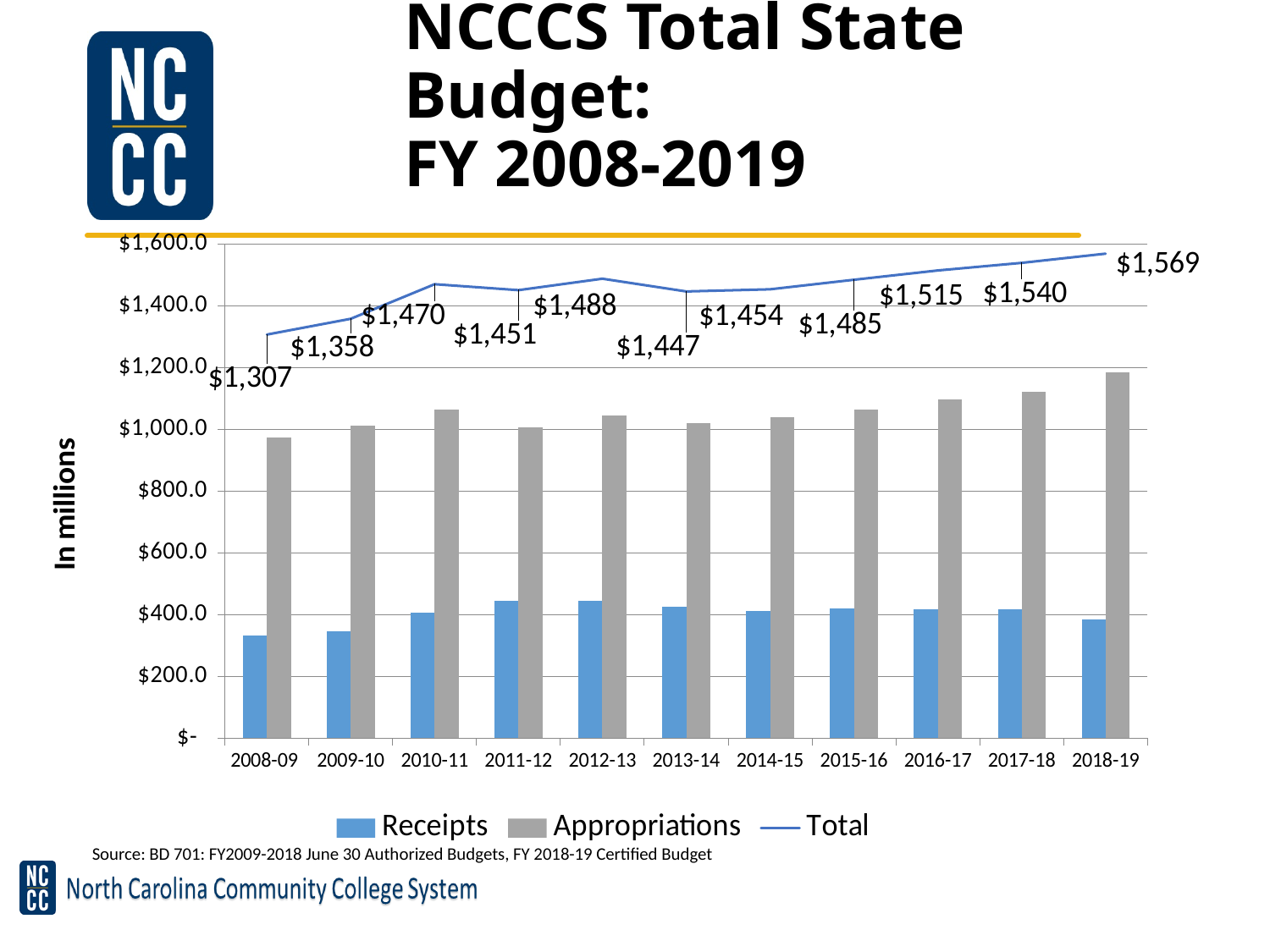
What is the Total value for 2018-19? $1,569 Is the Receipts value for 2008-09 greater or less than $400.0? less What is the Total value for 2008-09? $1,307 Which series is shown as a line rather than bars? Total How many series does the legend list? 3 What is the difference between the Total for 2018-19 and the Total for 2008-09? $262 Which fiscal year has the highest Total? 2018-19 Is the Total for 2012-13 larger or smaller than the Total for 2013-14? larger What is the Total value for 2012-13? $1,488 Is the Appropriations value for 2018-19 greater or less than $1,000.0? greater How many fiscal years are shown on the x axis? 11 Which fiscal year has the lowest Total? 2008-09